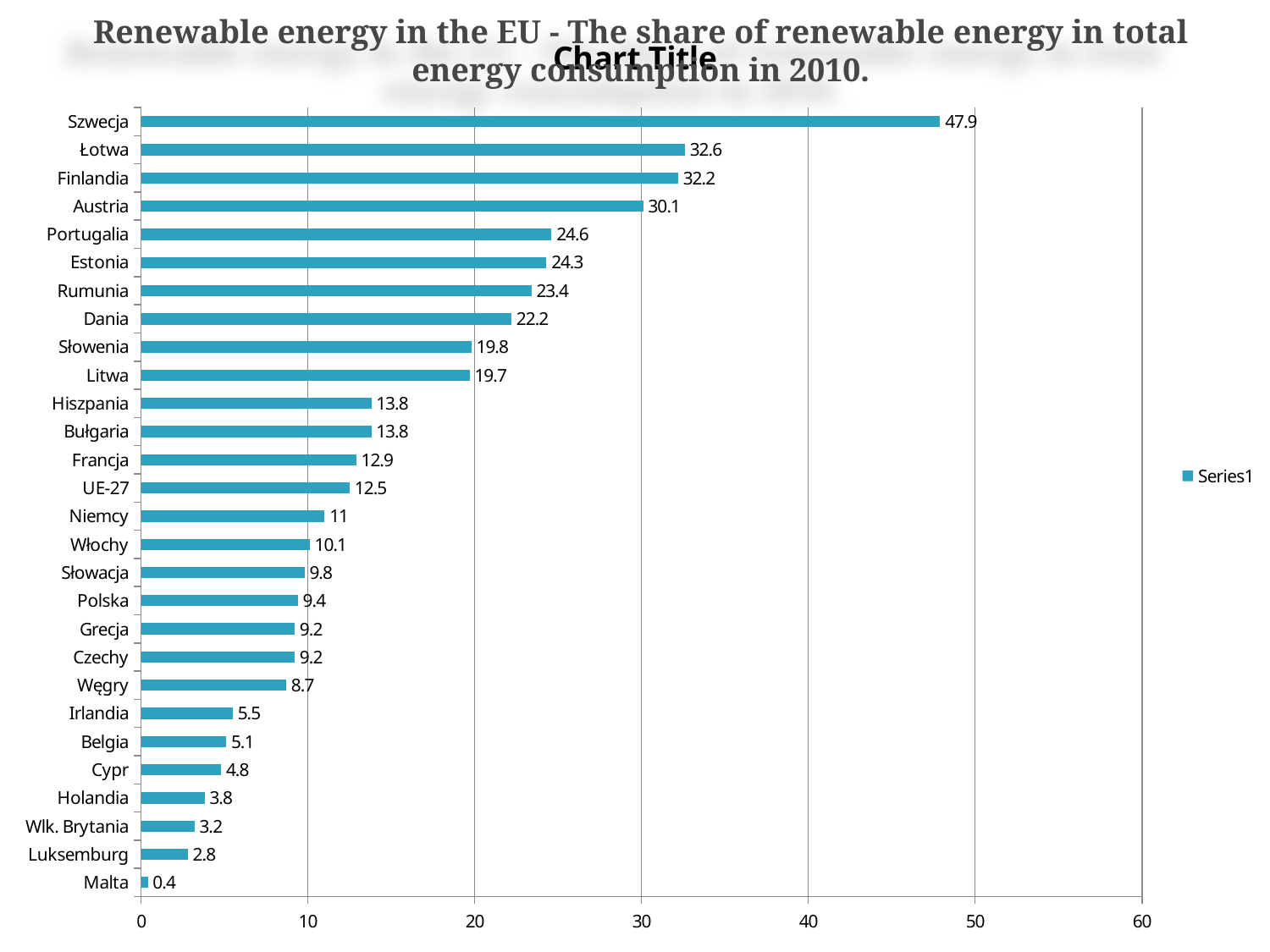
What is the value for Polska? 9.4 How many series does the legend list? 1 Which category has the lowest value? Malta What kind of chart is shown on the slide? bar chart Which is larger, the value for Austria or the value for Portugalia? Austria How many categories are shown in the chart? 28 Is the value for Finlandia greater or less than 30? greater What is the name of the series shown in the legend? Series1 What is the difference between the values for Szwecja and Łotwa? 15.3 What is the value for Szwecja? 47.9 What is the value for UE-27? 12.5 Which category has the highest value? Szwecja